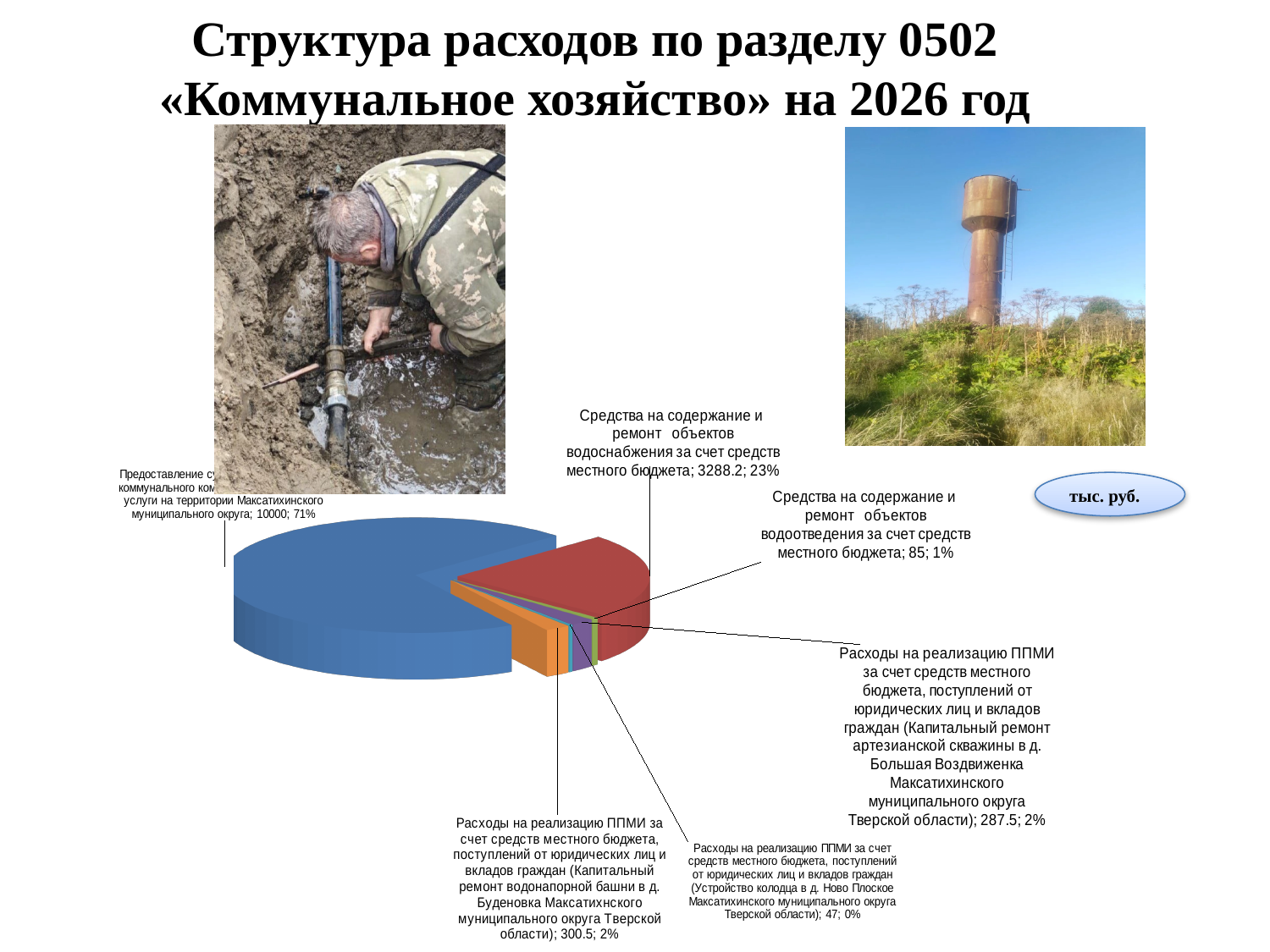
What is the difference between the value for водоснабжения (3288.2) and the value for водоотведения (85)? 3203.2 Which slice has the smallest value? Расходы на реализацию ППМИ (Устройство колодца в д. Ново Плоское); 47 What is the value for «Средства на содержание и ремонт объектов водоснабжения за счет средств местного бюджета»? 3288.2 What is the value for the ППМИ expenditure on the capital repair of the water tower in д. Буденовка? 300.5 How many slices does the pie chart have? 6 What is the value for «Средства на содержание и ремонт объектов водоотведения за счет средств местного бюджета»? 85 Which is larger: the ППМИ expenditure for the water tower in д. Буденовка or for the artesian well in д. Большая Воздвиженка? Water tower in д. Буденовка (300.5) What is the value for the ППМИ expenditure on the capital repair of the artesian well in д. Большая Воздвиженка? 287.5 What share of the pie does «Средства на содержание и ремонт объектов водоснабжения за счет средств местного бюджета» represent? 23% What share of the pie does the largest (blue) slice represent? 71% In what units are the values on the chart given, according to the callout on the slide? тыс. руб. What kind of chart is shown on the slide? Pie chart